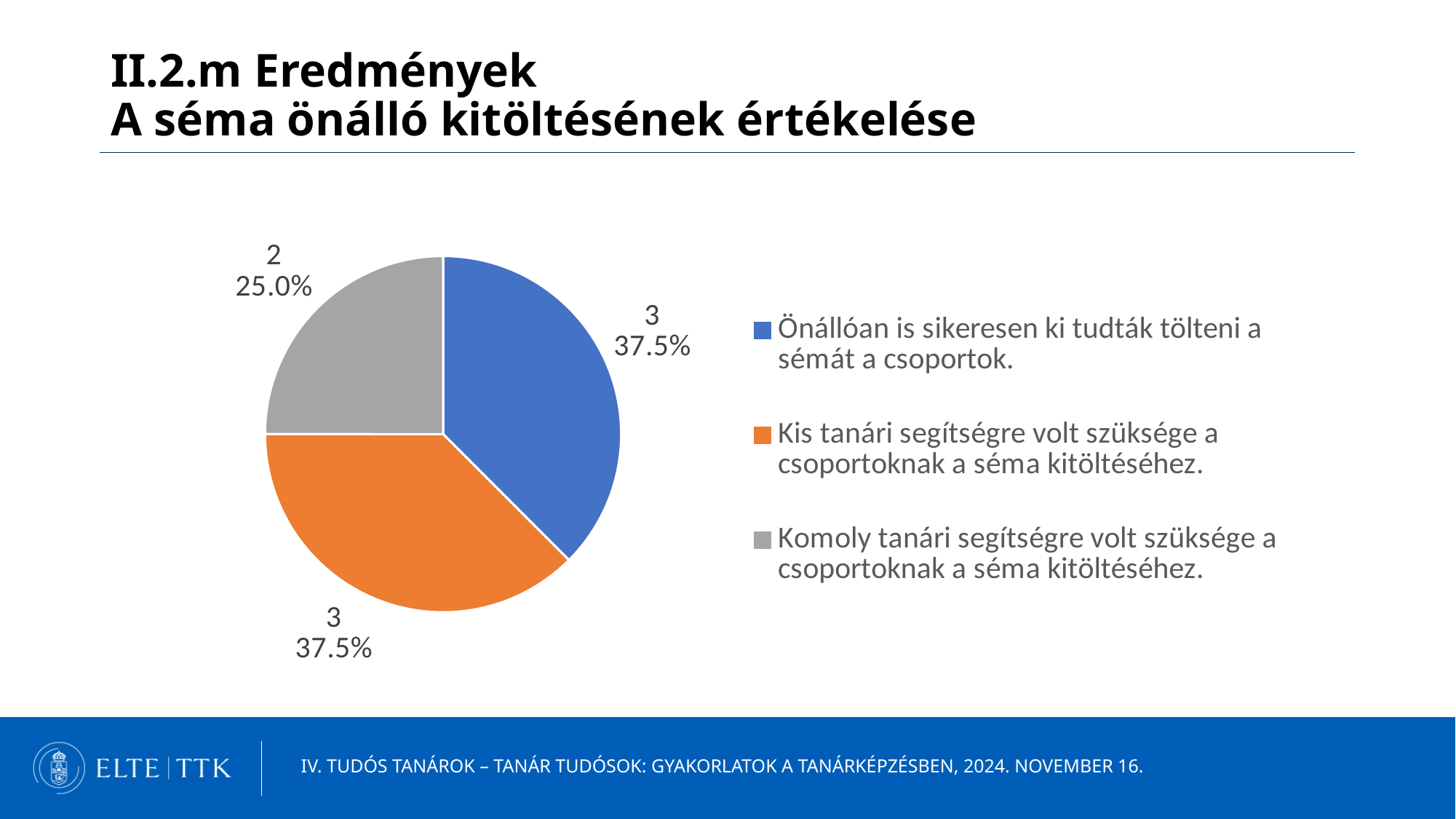
What colour is the slice for 'Kis tanári segítségre volt szüksége a csoportoknak a séma kitöltéséhez.'? orange Which category has the smallest slice of the pie? Komoly tanári segítségre volt szüksége a csoportoknak a séma kitöltéséhez. What is the count for the slice 'Önállóan is sikeresen ki tudták tölteni a sémát a csoportok.'? 3 What is the count for the slice 'Komoly tanári segítségre volt szüksége a csoportoknak a séma kitöltéséhez.'? 2 How many entries does the legend list? 3 What is the total count across all slices of the pie chart? 8 What is the difference in count between the 'Kis tanári segítségre' slice and the 'Komoly tanári segítségre' slice? 1 What percentage share does the slice 'Komoly tanári segítségre volt szüksége a csoportoknak a séma kitöltéséhez.' have? 25.0% Which is larger: the slice for 'Önállóan is sikeresen ki tudták tölteni a sémát a csoportok.' or the slice for 'Komoly tanári segítségre volt szüksége a csoportoknak a séma kitöltéséhez.'? Önállóan is sikeresen ki tudták tölteni a sémát a csoportok. What kind of chart is shown on the slide? pie chart What percentage share does the slice 'Kis tanári segítségre volt szüksége a csoportoknak a séma kitöltéséhez.' have? 37.5% How many slices does the pie chart have? 3